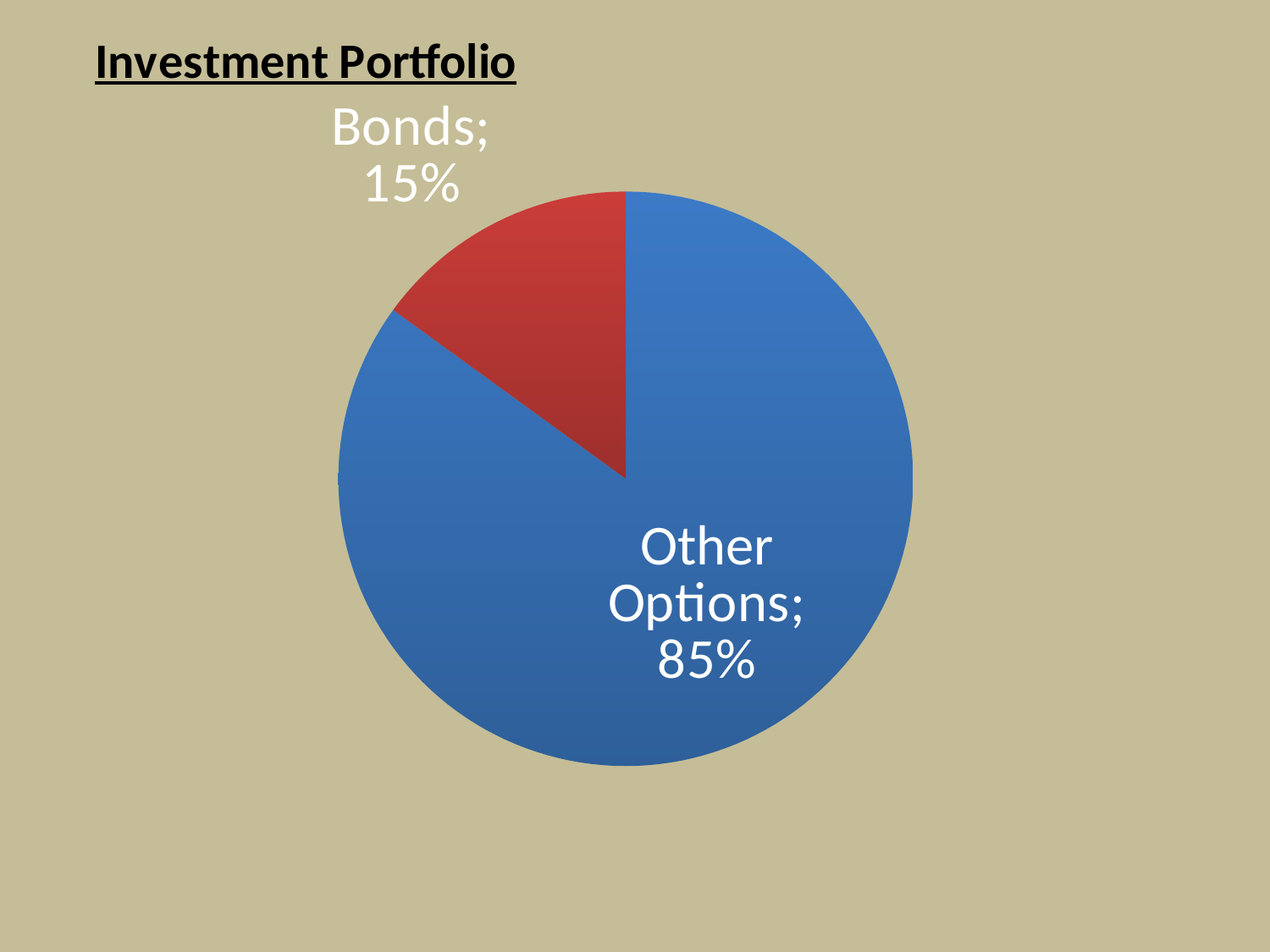
What is the difference in percentage points between Other Options and Bonds? 70 What share of the Investment Portfolio pie is Bonds? 15% Which slice of the pie is the smallest? Bonds What share of the Investment Portfolio pie is Other Options? 85% What is the title shown above the pie chart? Investment Portfolio What colour is the Bonds slice of the pie? red How many slices does the pie chart have? 2 Which slice of the pie is the largest? Other Options Which is larger, the Bonds slice or the Other Options slice? Other Options What kind of chart is shown on the slide? pie chart